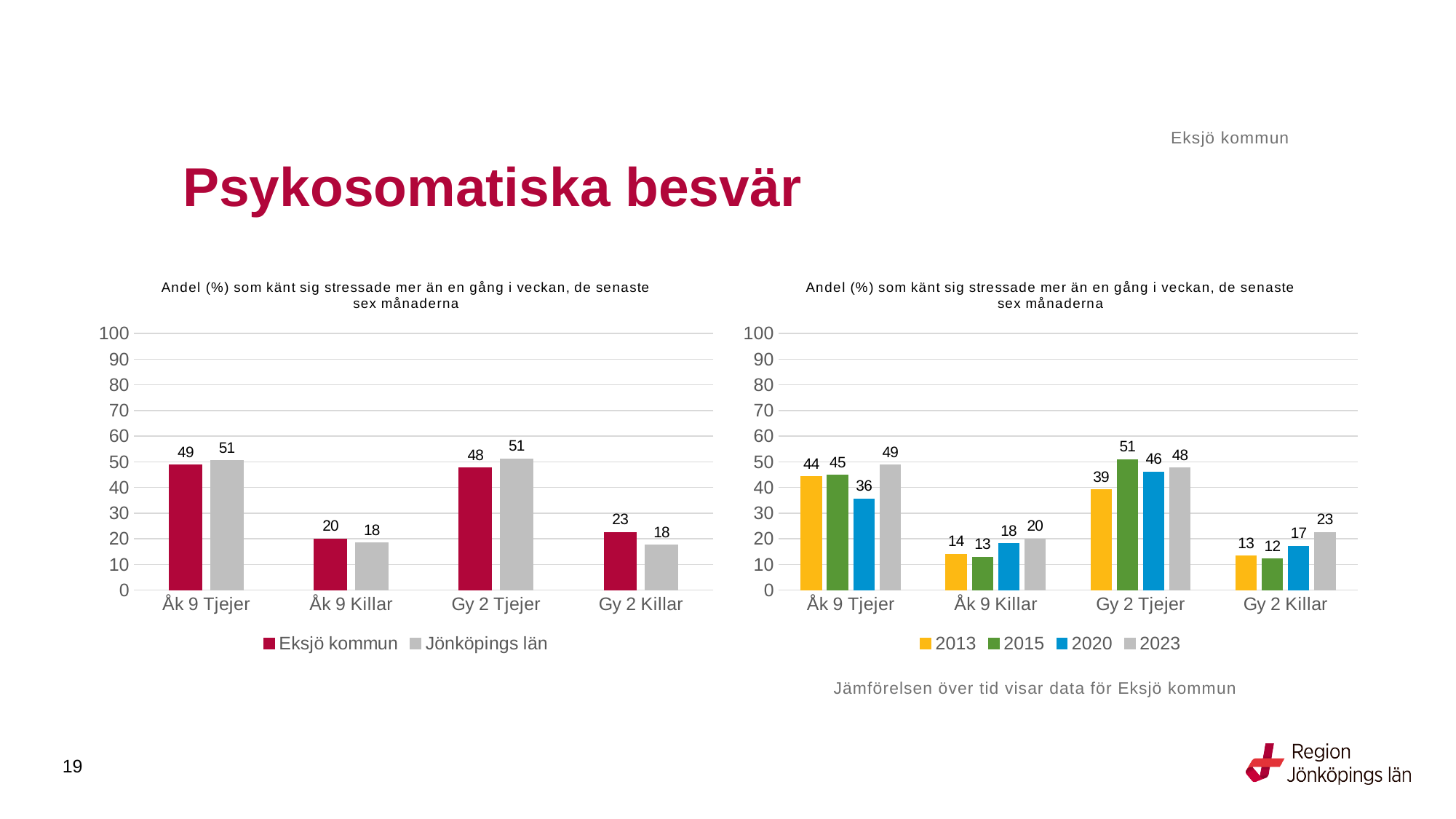
In the left chart, what is the difference between Jönköpings län and Eksjö kommun for Gy 2 Tjejer? 3 What kind of chart is the right chart? bar chart In the right chart, what is the value for 2020 for Åk 9 Tjejer? 36 In the right chart, which year has the highest value for Gy 2 Tjejer? 2015 In the right chart, what is the difference between the 2023 and 2013 values for Gy 2 Killar? 10 In the left chart, what is the value for Jönköpings län for Gy 2 Killar? 18 How many series does the legend of the right chart list? 4 In the left chart, which is larger for Åk 9 Killar: Eksjö kommun or Jönköpings län? Eksjö kommun In the right chart, do the values for Åk 9 Killar rise or fall from 2015 to 2023? rise How many series does the legend of the left chart list? 2 In the left chart, what is the value for Eksjö kommun for Åk 9 Tjejer? 49